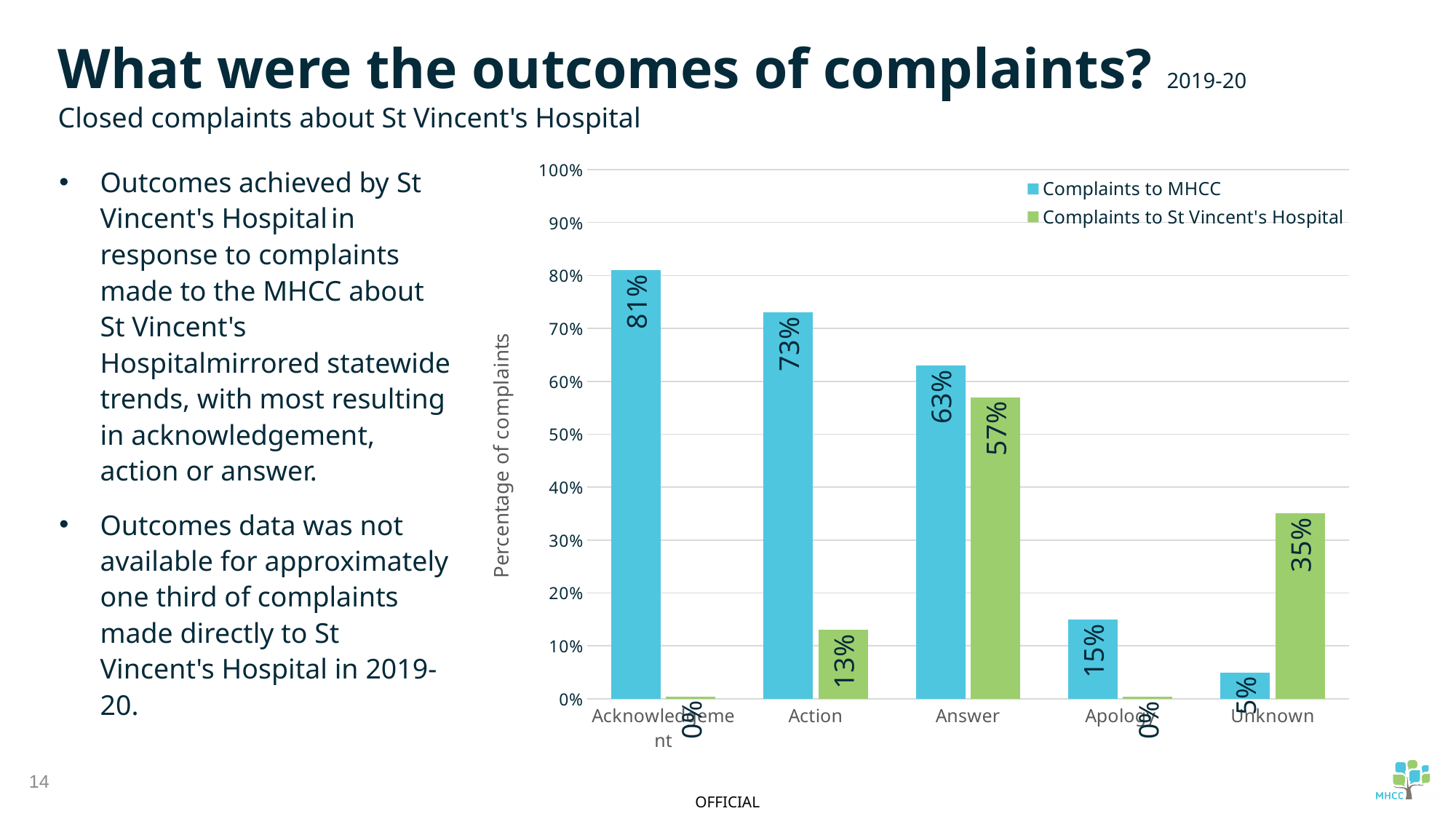
What percentage of complaints to MHCC resulted in Acknowledgement? 81% How many series does the legend list? 2 What kind of chart is shown on the slide? Bar chart What percentage of complaints to St Vincent's Hospital resulted in Answer? 57% What percentage of complaints to St Vincent's Hospital had an Unknown outcome? 35% What percentage of complaints to MHCC resulted in Apology? 15% Which outcome category has the highest value for Complaints to MHCC? Acknowledgement What is the label of the y axis? Percentage of complaints What is the difference between the Complaints to MHCC and Complaints to St Vincent's Hospital values for Action? 60% How many outcome categories are shown on the x axis? 5 Which outcome category has the lowest value for Complaints to MHCC? Unknown For the Answer category, which series has the larger value: Complaints to MHCC or Complaints to St Vincent's Hospital? Complaints to MHCC